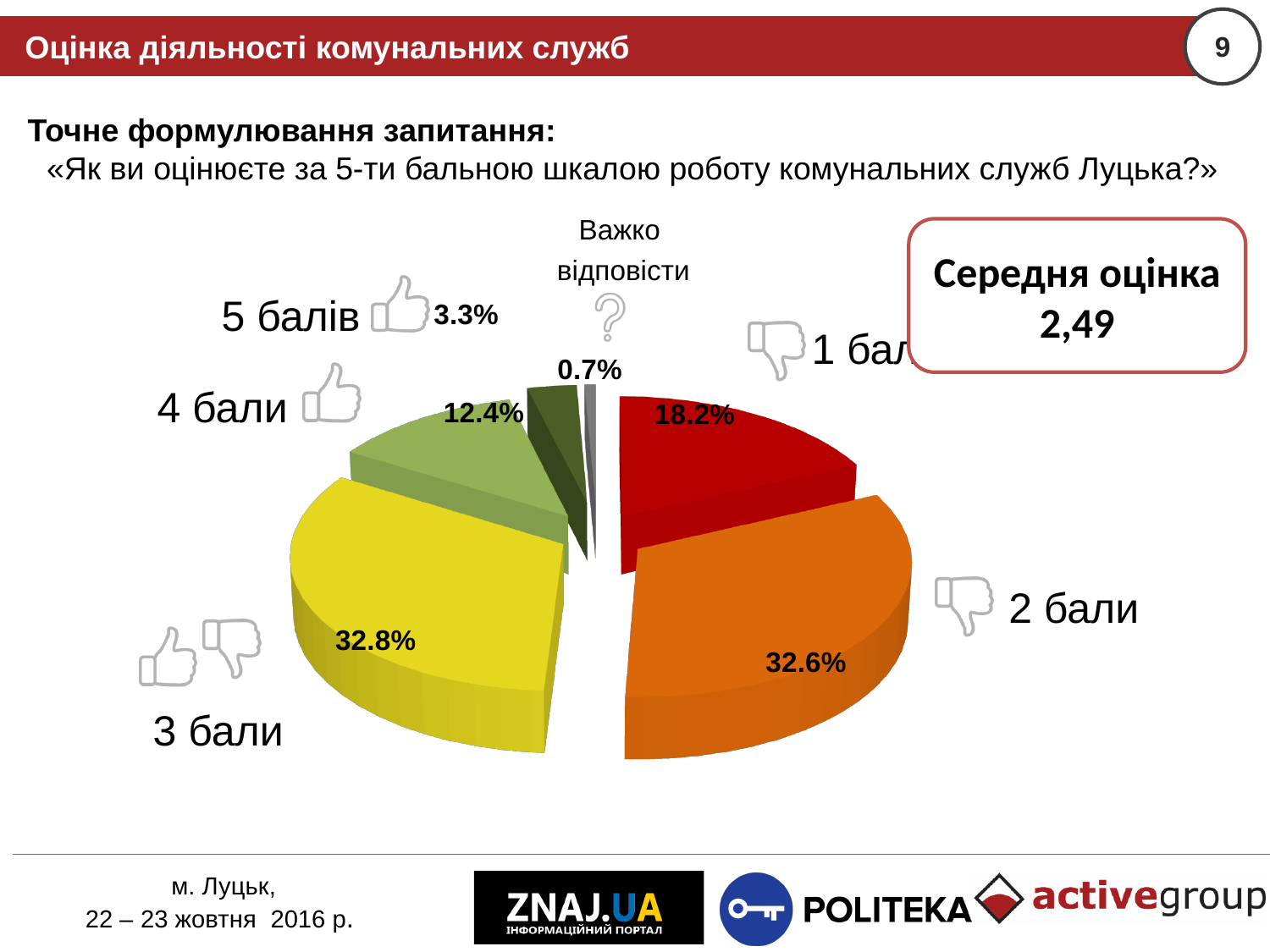
What is the difference in percentage points between the 1 бал slice and the 5 балів slice? 14.9 What percentage is shown for 1 бал? 18.2% What type of chart is shown on the slide? Pie chart Which is larger: the share for 1 бал or the share for 4 бали? 1 бал What share of the pie corresponds to 2 бали? 32.6% What percentage of respondents answered 'Важко відповісти'? 0.7% What percentage of respondents gave 5 балів? 3.3% What percentage of respondents rated the utility services 3 бали? 32.8% What percentage of respondents gave 4 бали? 12.4% What average score (Середня оцінка) is shown in the box on the slide? 2,49 Which category has the smallest slice of the pie? Важко відповісти How many slices does the pie chart have? 6